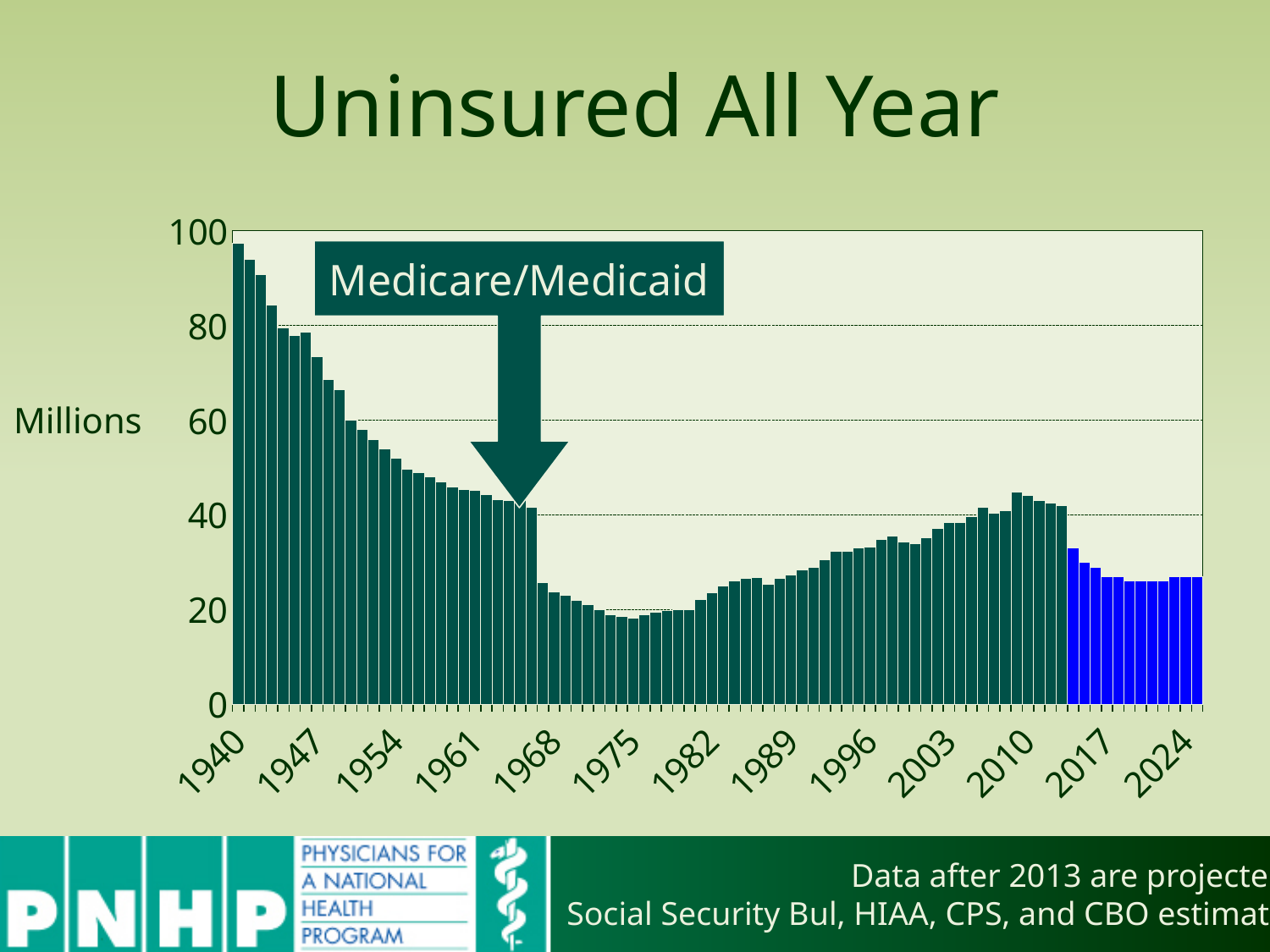
Is the value for 2024 greater or less than 20? greater Is the value for 1968 greater or less than 40? less Which is larger, the value for 2010 or the value for 1975? 2010 Is the value for 1940 greater or less than 80? greater Which is larger, the value for 1940 or the value for 2024? 1940 What is the title of the chart? Uninsured All Year What unit label is shown on the y axis of the chart? Millions Do the values rise or fall from 1940 to 1975? fall Which year has the highest value in the chart? 1940 What kind of chart is shown on the slide? bar chart